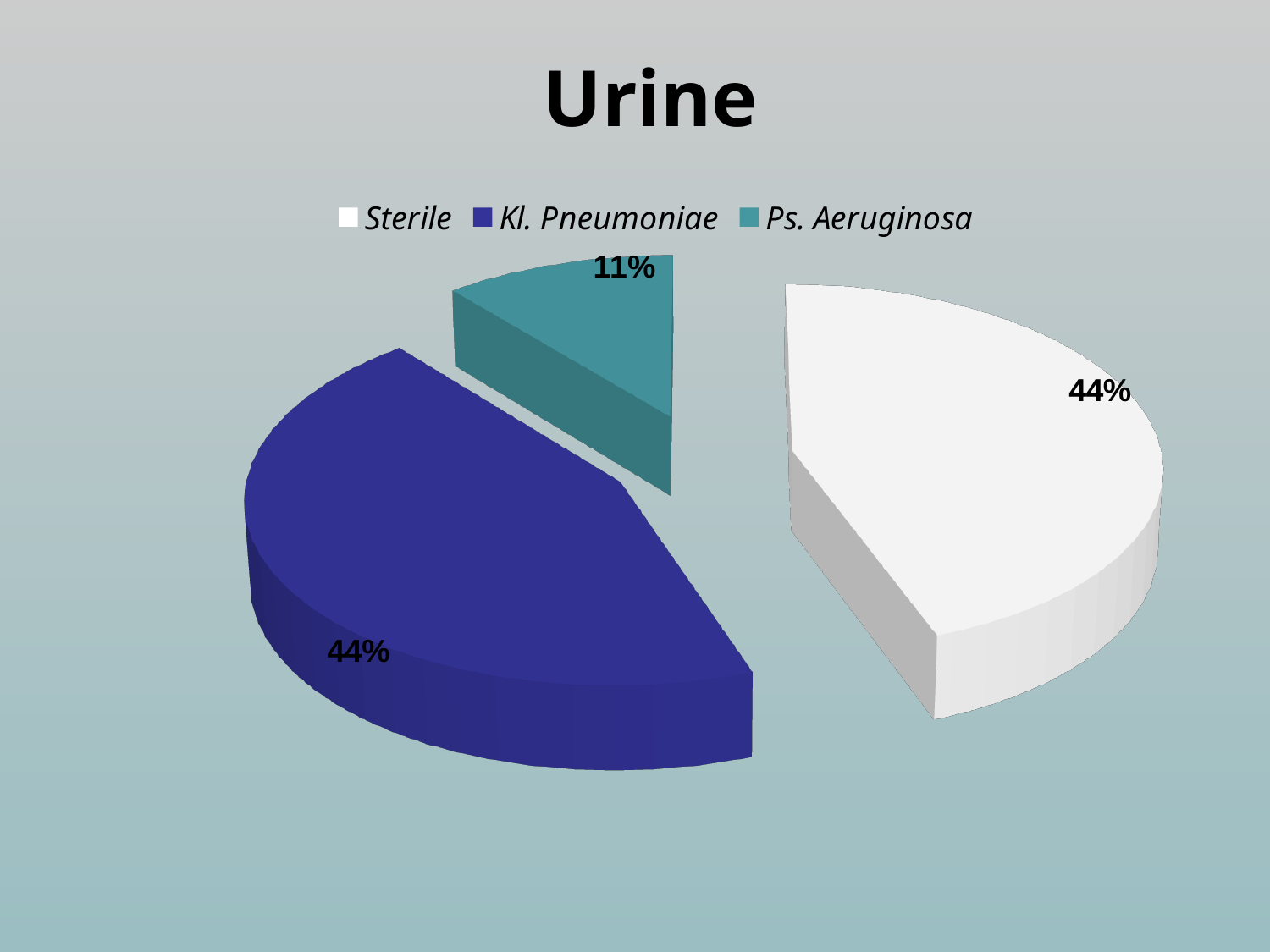
Which legend entry is shown in white? Sterile What share of the pie is Kl. Pneumoniae? 44% Which is larger, the share for Sterile or the share for Ps. Aeruginosa? Sterile What share of the pie is Ps. Aeruginosa? 11% What share of the pie is Sterile? 44% How many slices does the pie chart have? 3 What is the difference between the share for Kl. Pneumoniae and the share for Ps. Aeruginosa? 33% How many entries does the legend list? 3 Which category has the smallest slice? Ps. Aeruginosa What kind of chart is shown on the slide? pie chart What is the title of the chart? Urine